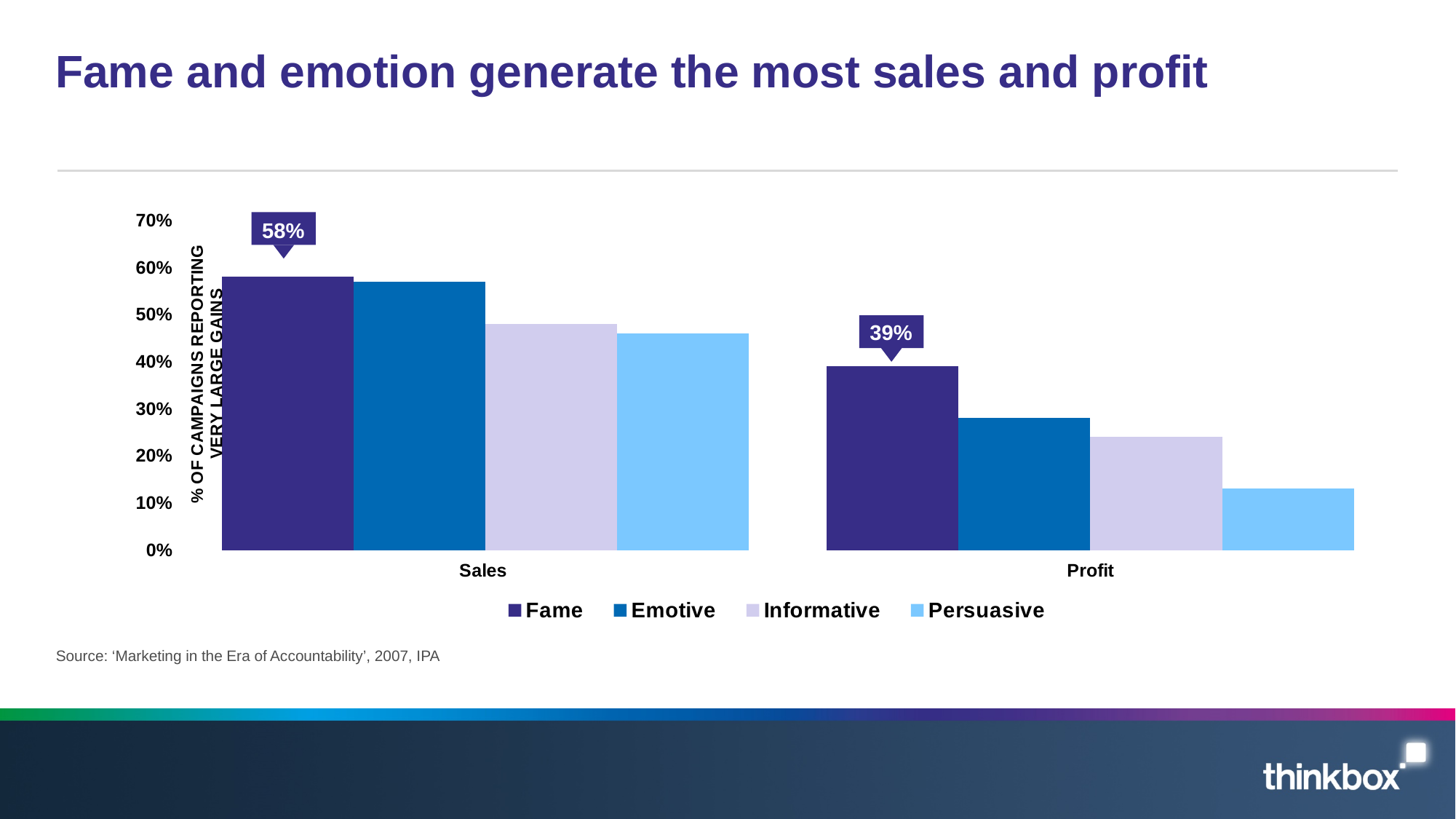
What kind of chart is shown on the slide? Bar chart What is the label on the vertical axis of the chart? % of campaigns reporting very large gains What is the value for Fame in the Profit category? 39% Which series has the lowest value in the Profit category? Persuasive What is the difference between the Fame value for Sales and the Fame value for Profit? 19 percentage points Which series has the highest value in the Profit category? Fame Is the value for Persuasive in the Profit category greater or less than 20%? less How many series does the legend list? 4 How many categories are shown on the x axis? 2 What percentage of campaigns reported very large gains in Sales for the Fame series? 58% Is the value for Informative in the Sales category greater or less than 40%? greater Is the Fame value larger for Sales or for Profit? Sales